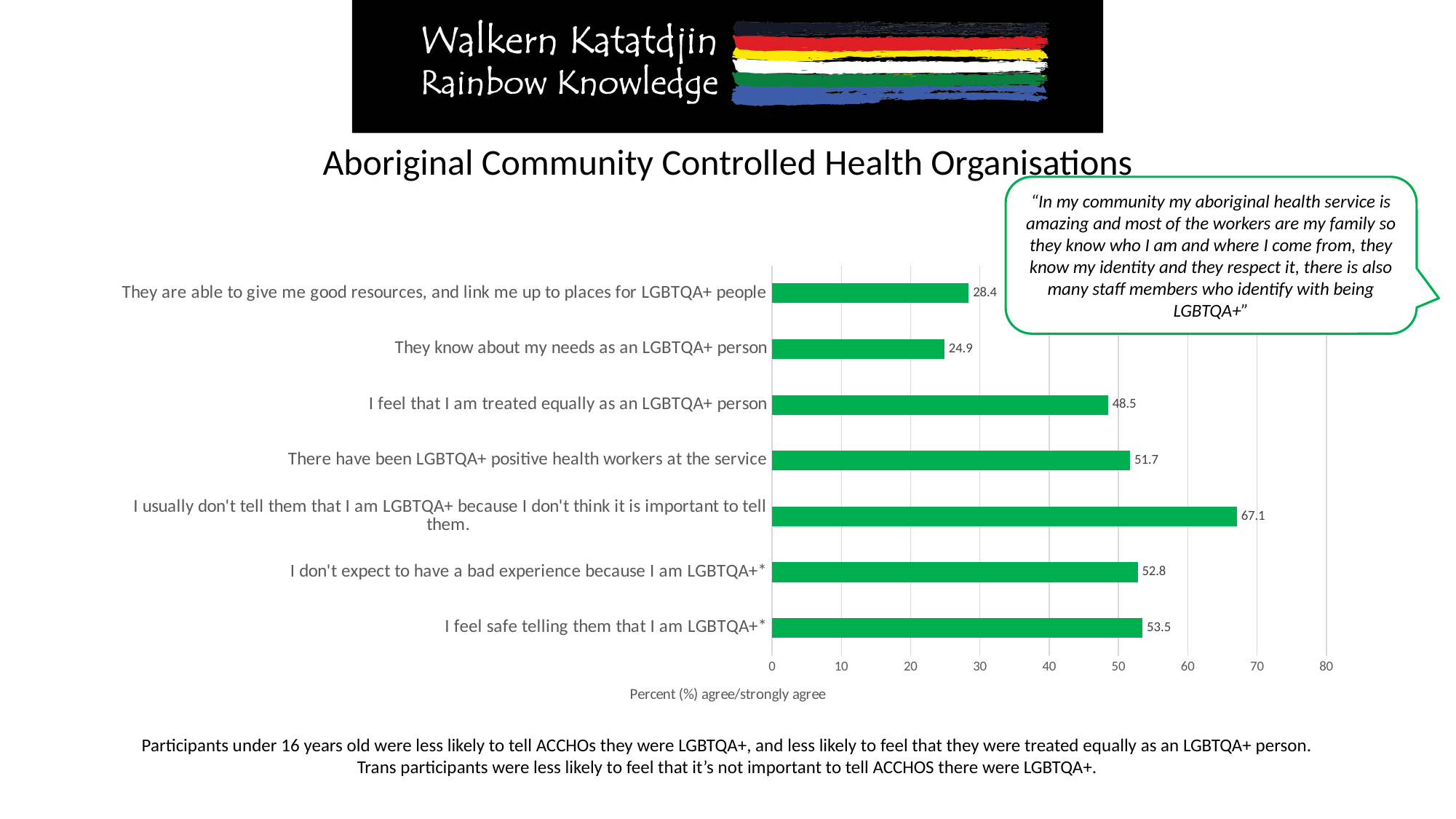
What is the value for 'There have been LGBTQA+ positive health workers at the service'? 51.7 Which statement has the lowest percentage of agree/strongly agree? They know about my needs as an LGBTQA+ person What is the value for 'They know about my needs as an LGBTQA+ person'? 24.9 How many statements (bars) are shown in the chart? 7 Is the value for 'I usually don't tell them that I am LGBTQA+ because I don't think it is important to tell them.' greater or less than 60? greater Which is larger: the value for 'I feel that I am treated equally as an LGBTQA+ person' or the value for 'They are able to give me good resources, and link me up to places for LGBTQA+ people'? I feel that I am treated equally as an LGBTQA+ person What percentage of participants agreed or strongly agreed that they feel safe telling them that they are LGBTQA+? 53.5 What is the difference between the value for 'I feel safe telling them that I am LGBTQA+*' and the value for 'I don't expect to have a bad experience because I am LGBTQA+*'? 0.7 What colour are the bars in the chart? green What is the label of the horizontal axis of the chart? Percent (%) agree/strongly agree Which statement has the highest percentage of agree/strongly agree? I usually don't tell them that I am LGBTQA+ because I don't think it is important to tell them. What type of chart is shown on the slide? bar chart